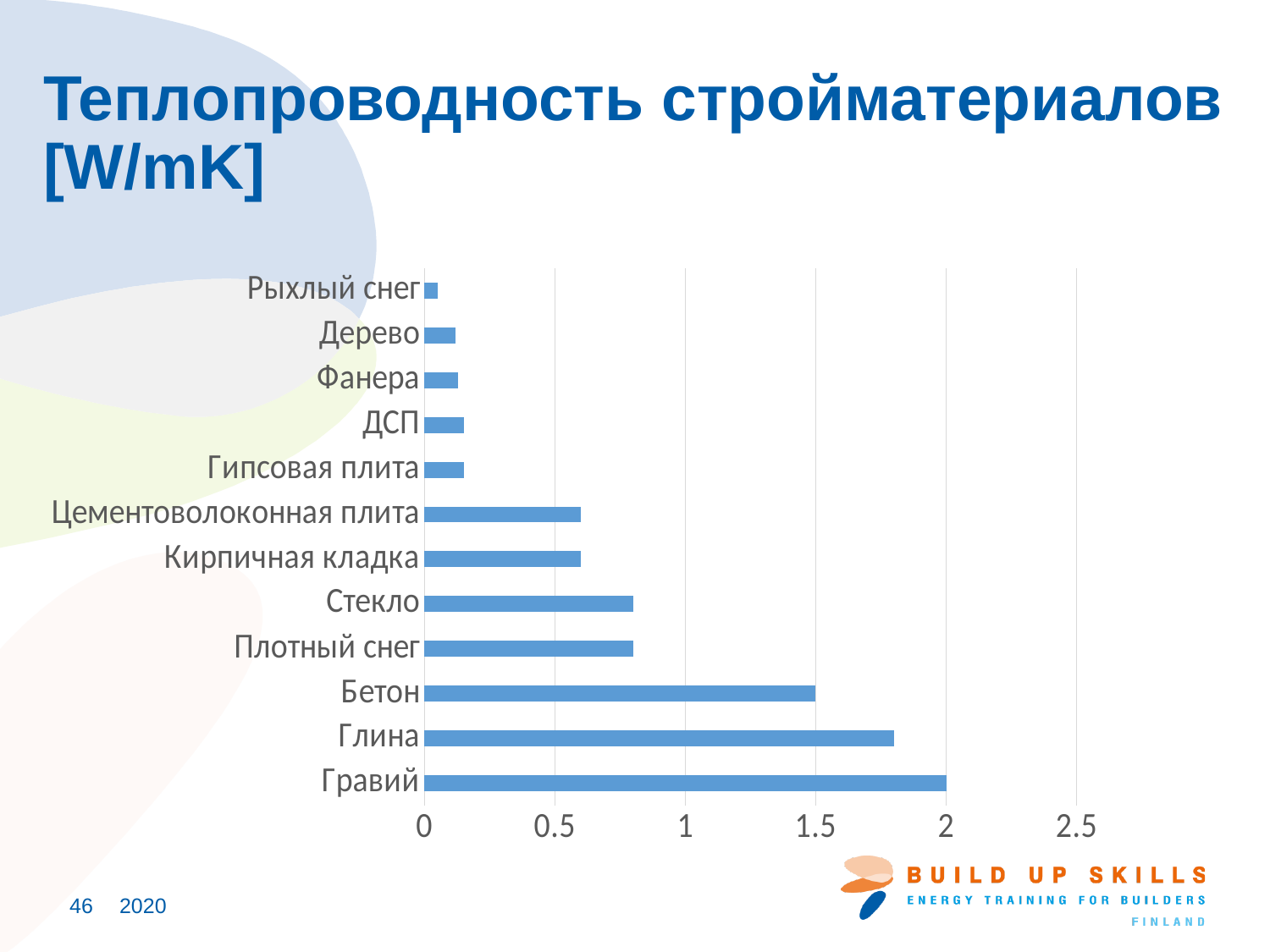
How many materials (categories) are plotted in the chart? 12 What is the thermal conductivity value for Гравий? 2 Which material has the lowest thermal conductivity in the chart? Рыхлый снег Is the value for Глина greater or less than 1.5? greater Which has the larger value, Глина or Бетон? Глина What is the title of the slide containing the chart? Теплопроводность стройматериалов [W/mK] Which material has the highest thermal conductivity in the chart? Гравий Is the value for Кирпичная кладка greater or less than 0.5? greater What is the thermal conductivity value for Бетон? 1.5 What kind of chart is shown on the slide? bar chart What is the difference between the values for Гравий and Бетон? 0.5 Is the value for Стекло greater or less than 1? less